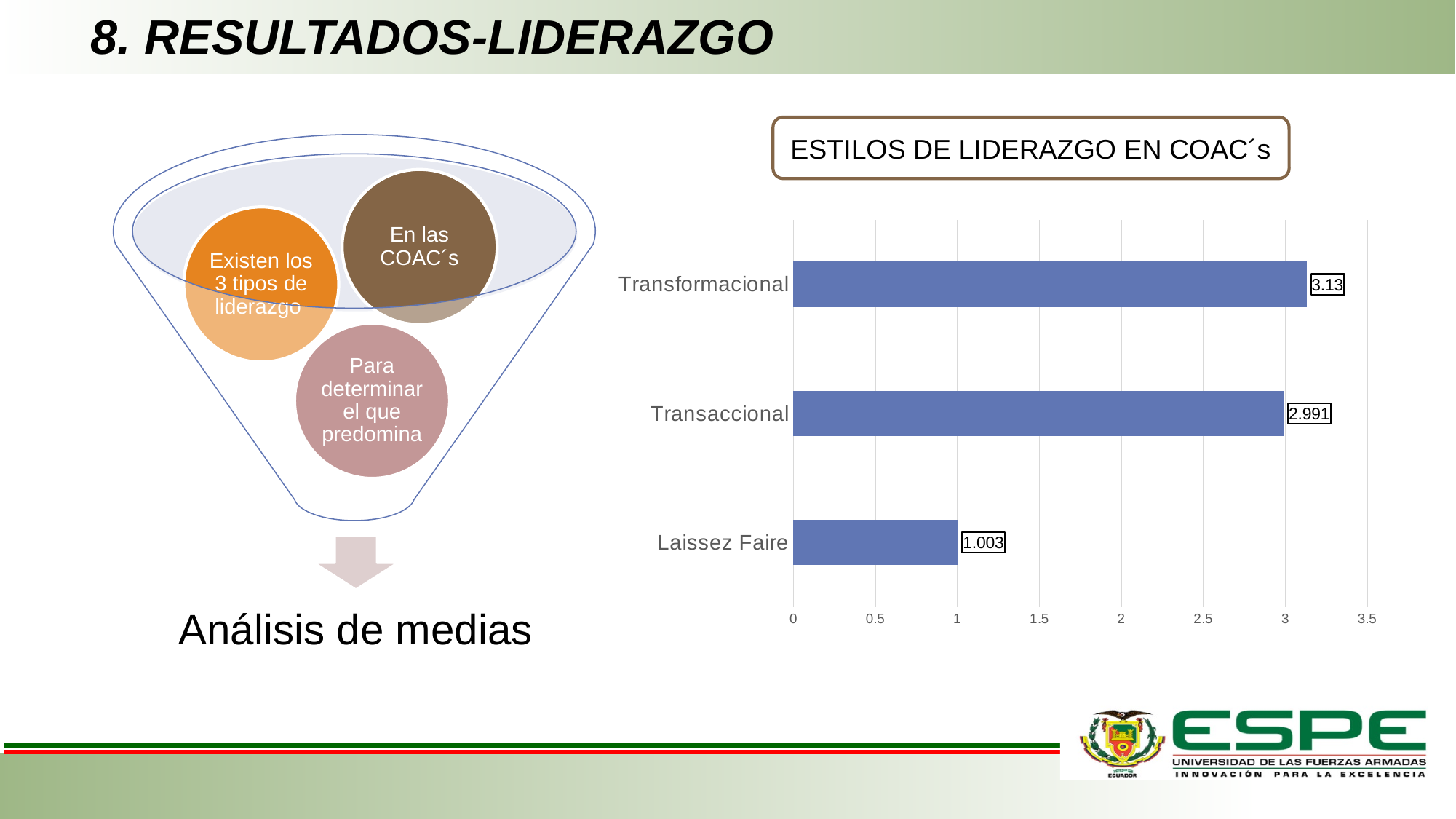
What is the value for Laissez Faire? 1.003 What is the difference between the values for Transformacional and Transaccional? 0.139 What is the value for Transaccional? 2.991 What is the value for Transformacional? 3.13 Which is larger, the value for Transaccional or the value for Laissez Faire? Transaccional Is the value for Transaccional greater or less than 2.5? greater Which leadership style has the lowest value? Laissez Faire How many leadership styles are shown in the chart? 3 Which leadership style has the highest value? Transformacional What kind of chart is shown on the slide? Bar chart What is the difference between the values for Transaccional and Laissez Faire? 1.988 What is the title of the chart? ESTILOS DE LIDERAZGO EN COAC´s